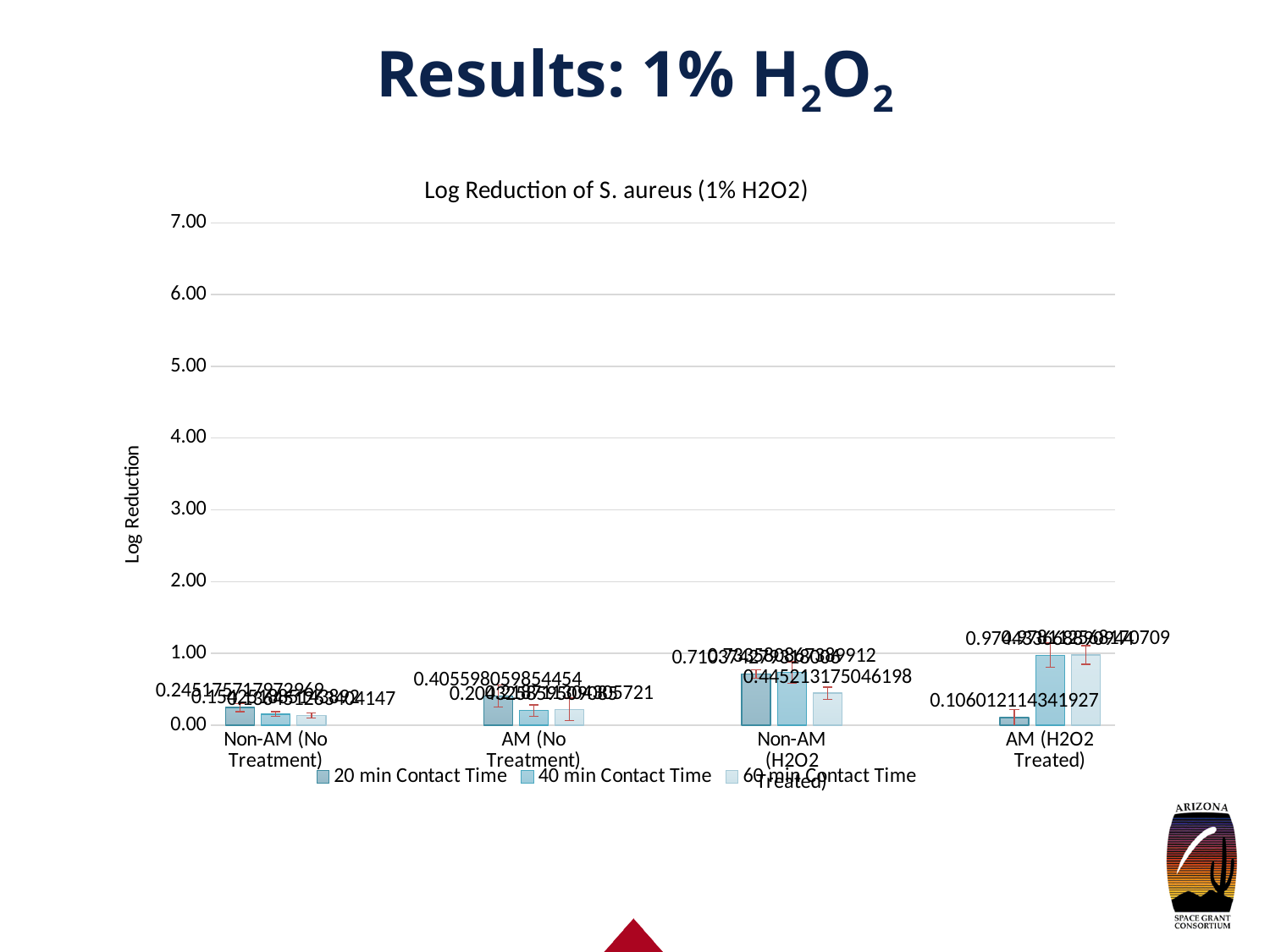
What is the label of the y axis? Log Reduction Is the value for 20 min Contact Time in the Non-AM (No Treatment) category greater or less than 1.00? less What is the value for 20 min Contact Time in the AM (No Treatment) category? 0.4055980598544454 How many series does the legend list? 3 Which is larger: the 20 min Contact Time value for Non-AM (H2O2 Treated) or for Non-AM (No Treatment)? Non-AM (H2O2 Treated) What is the value for 20 min Contact Time in the AM (H2O2 Treated) category? 0.106012114341927 Is the value for 20 min Contact Time in the Non-AM (H2O2 Treated) category greater or less than 1.00? less What kind of chart is shown on the slide? bar chart Within the AM (H2O2 Treated) category, which contact time has the lowest value? 20 min Contact Time How many categories are shown on the x axis? 4 What is the title of the chart? Log Reduction of S. aureus (1% H2O2) Within the Non-AM (H2O2 Treated) category, which contact time has the lowest value? 60 min Contact Time